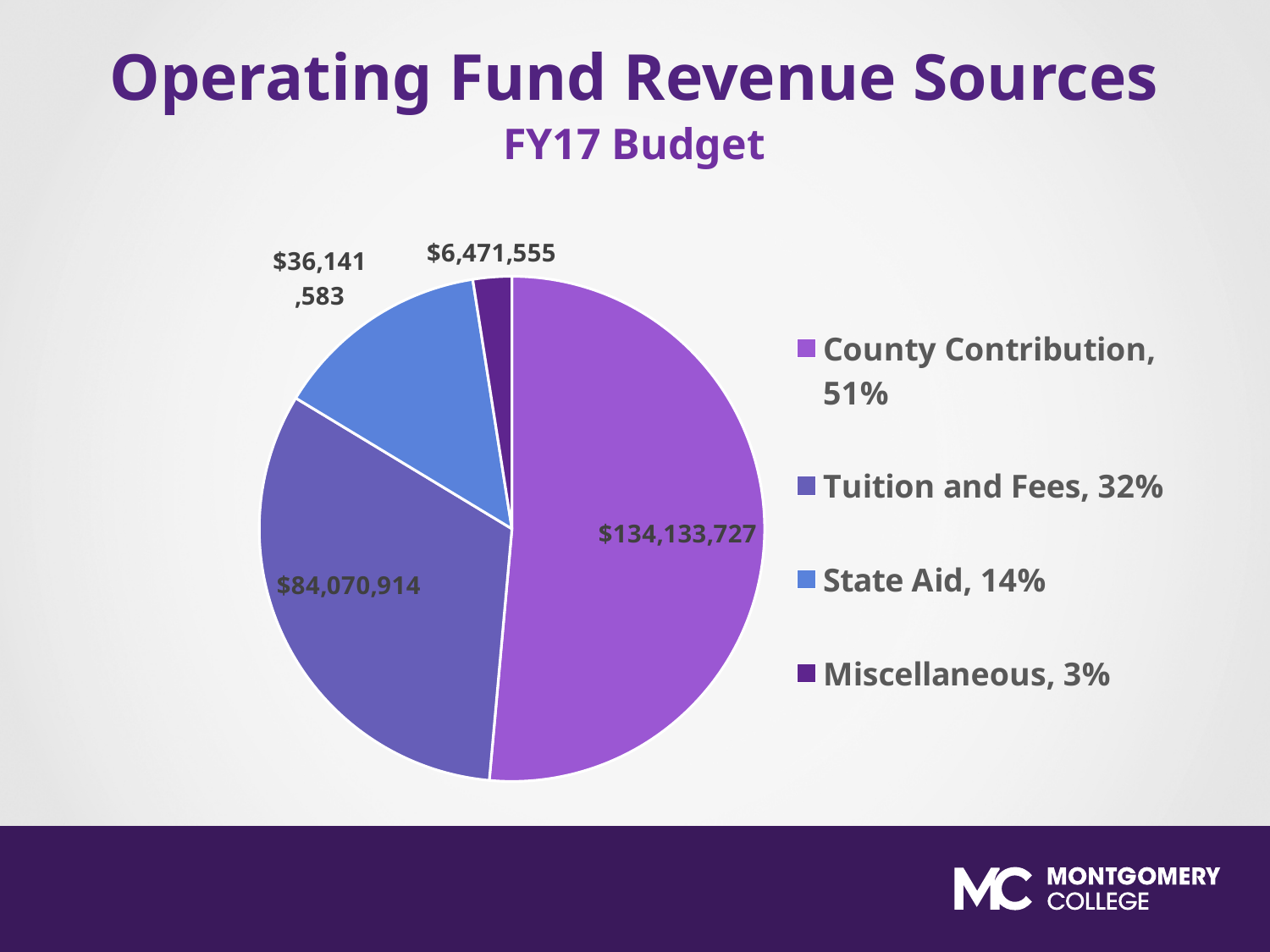
What share of the pie does State Aid represent? 14% What type of chart is shown on the slide? Pie chart Which revenue source is the smallest? Miscellaneous What share of the pie does Tuition and Fees represent? 32% How many revenue sources are shown in the pie chart? 4 What is the value for State Aid? $36,141,583 What is the difference between County Contribution and Tuition and Fees? $50,062,813 What is the value for Miscellaneous? $6,471,555 What is the value for Tuition and Fees? $84,070,914 Which revenue source is the largest? County Contribution What is the value for County Contribution? $134,133,727 Which is larger, State Aid or Miscellaneous? State Aid